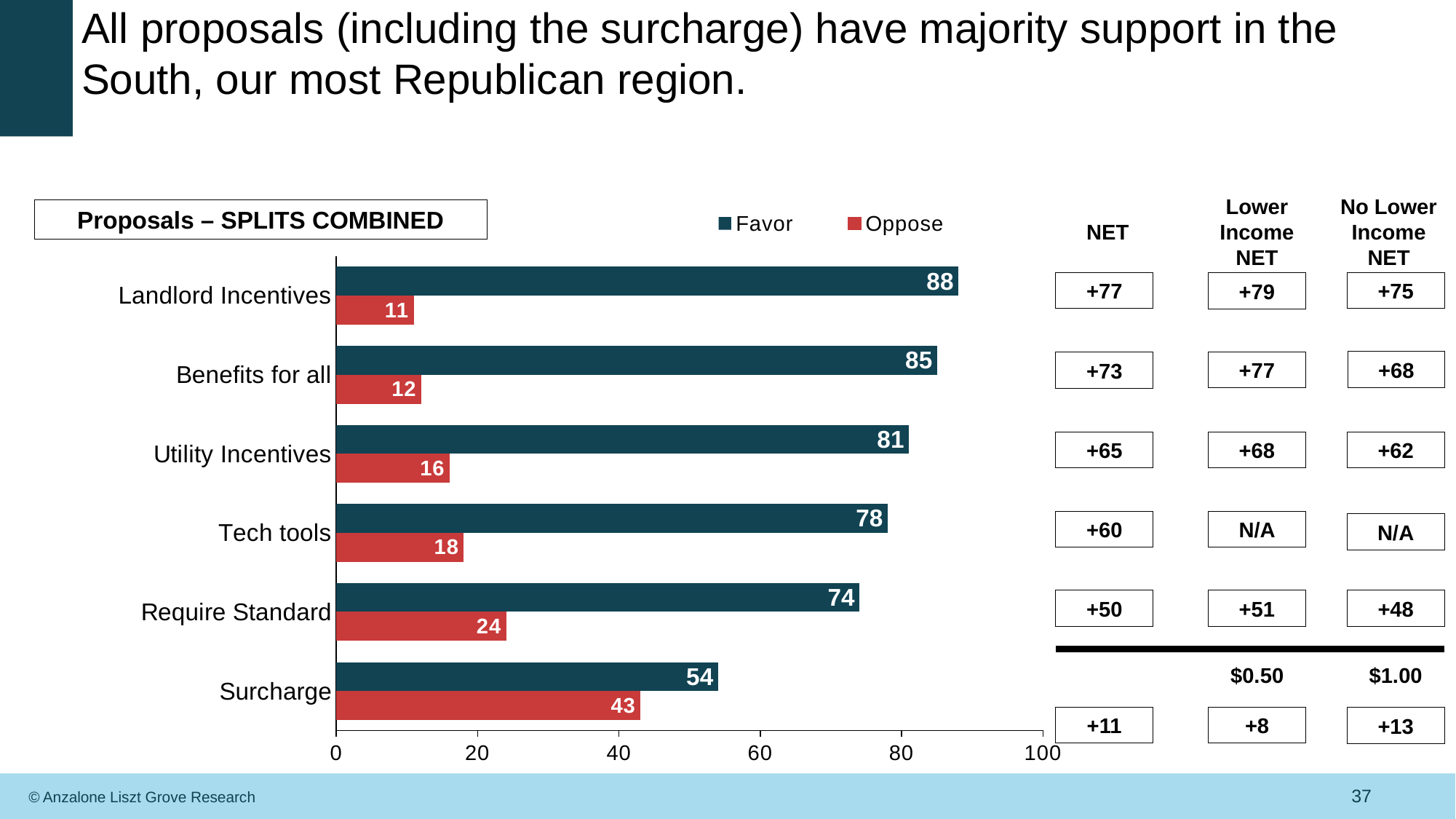
Which proposal has the highest Favor value? Landlord Incentives What is the Oppose value for Surcharge? 43 How many proposals are shown on the chart? 6 What is the title shown in the box above the chart? Proposals – SPLITS COMBINED Which proposal has the lowest Oppose value? Landlord Incentives Which proposal has the lowest Favor value? Surcharge Which is larger, the Oppose value for Utility Incentives or the Oppose value for Tech tools? Tech tools How many series does the legend list? 2 What is the Favor value for Tech tools? 78 What is the Favor value for Landlord Incentives? 88 What is the difference between the Favor and Oppose values for Require Standard? 50 What kind of chart is shown on the slide? Bar chart